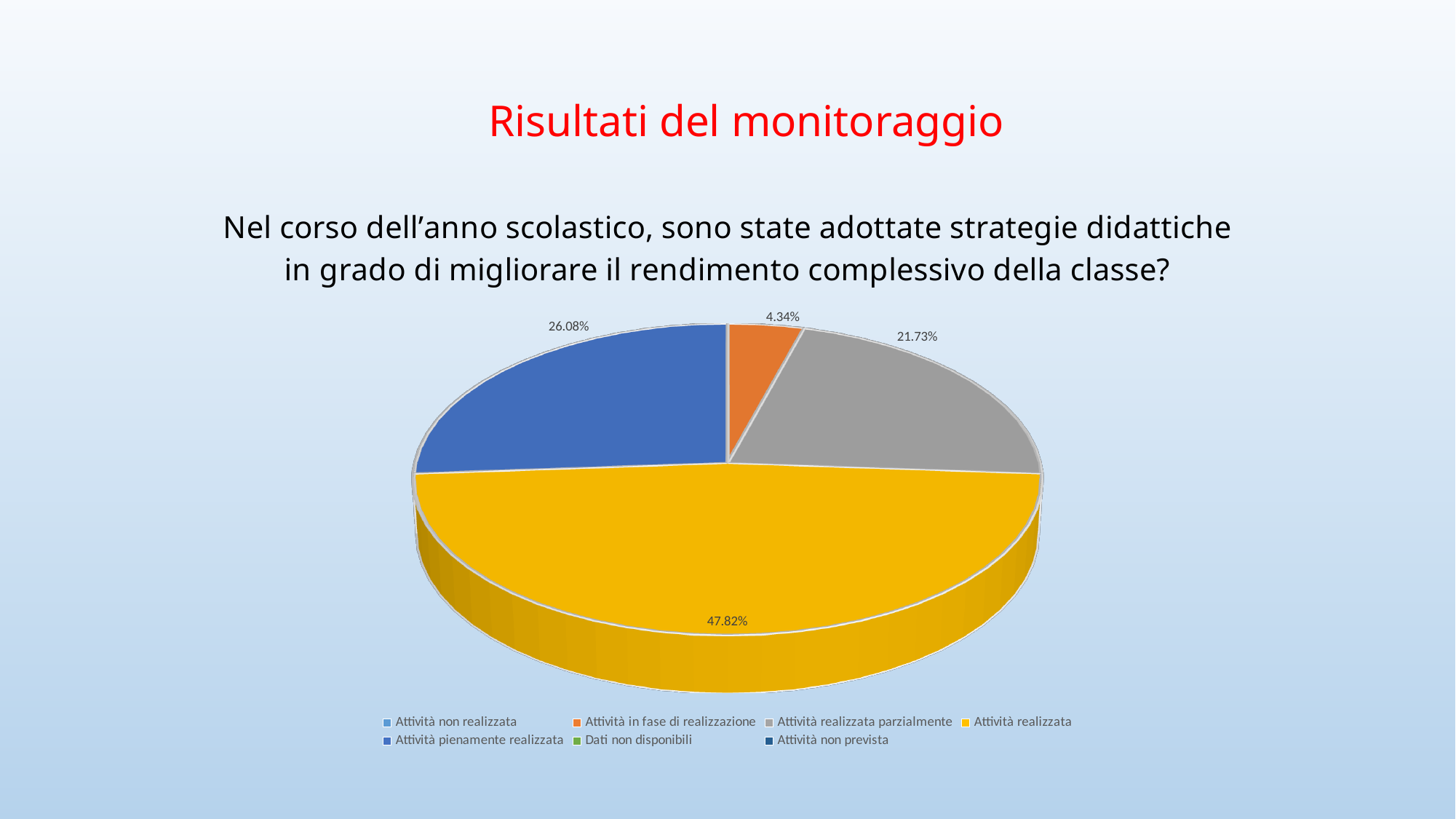
What is the title of the slide? Risultati del monitoraggio How many slices are visible in the pie? 4 What kind of chart is shown on the slide? pie chart What percentage is shown on the blue slice of the pie? 26.08% Which is larger: "Attività realizzata parzialmente" or "Attività in fase di realizzazione"? Attività realizzata parzialmente What percentage is shown for "Attività in fase di realizzazione"? 4.34% What is the difference in percentage points between "Attività realizzata" and "Attività realizzata parzialmente"? 26.09% Which category has the largest slice of the pie? Attività realizzata Which category has the smallest visible slice of the pie? Attività in fase di realizzazione How many entries does the legend list? 7 What percentage is shown for "Attività realizzata parzialmente"? 21.73% What percentage is shown for "Attività realizzata"? 47.82%